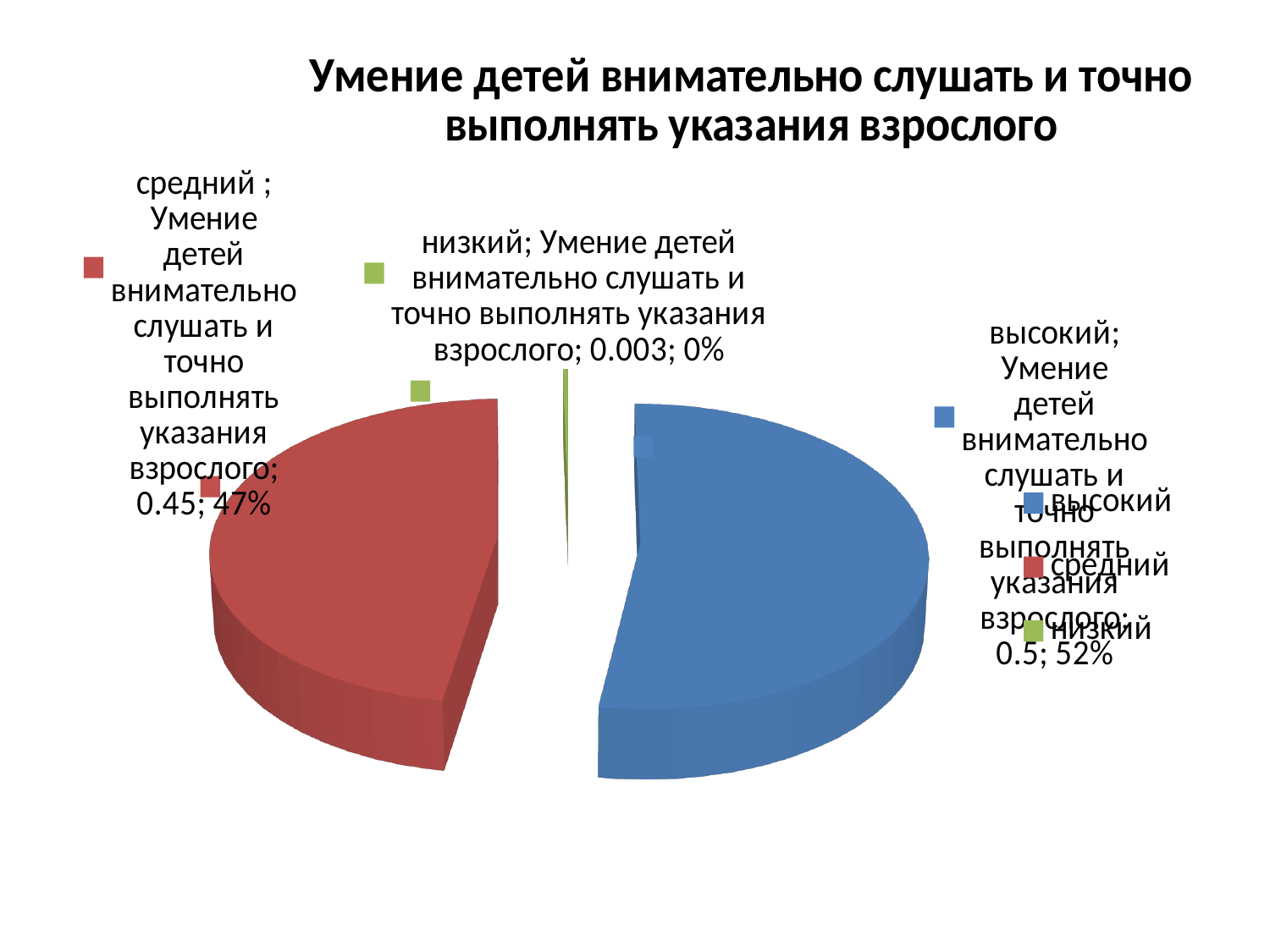
What is the title of the chart? Умение детей внимательно слушать и точно выполнять указания взрослого Which category has the smallest slice? низкий Which legend entry is shown in green? низкий What value is shown for the 'средний' slice? 0.45 Which category has the largest slice? высокий What share of the pie does the 'высокий' slice represent? 52% What value is shown for the 'низкий' slice? 0.003 What share of the pie does the 'средний' slice represent? 47% How many slices does the pie chart have? 3 What value is shown for the 'высокий' slice? 0.5 What kind of chart is shown on the slide? pie chart How many entries does the legend list? 3